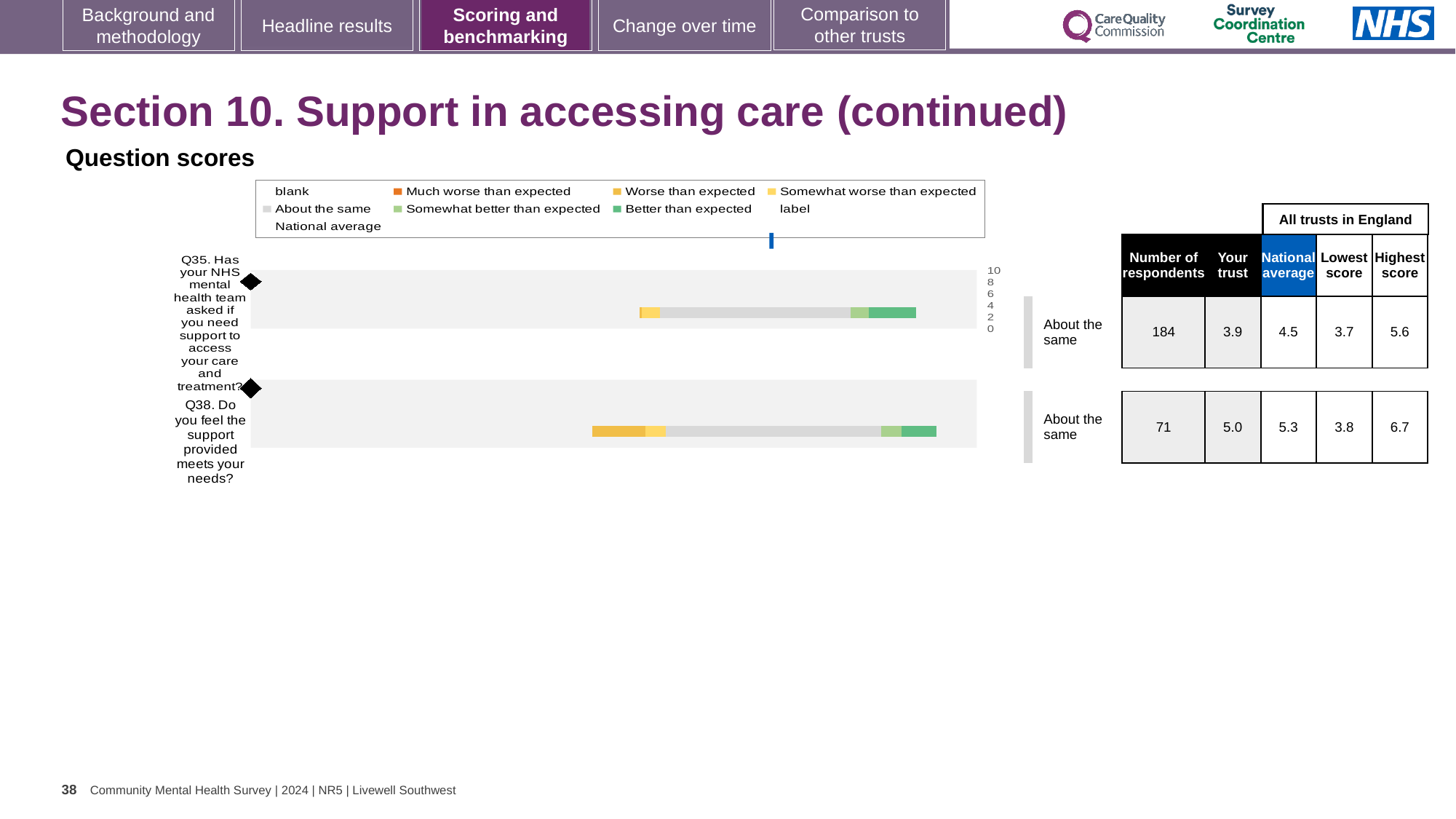
What is the difference between the highest and lowest scores among all trusts in England for Q38? 2.9 How many questions (categories) are plotted in the question scores chart? 2 What is the 'Your trust' score for Q35 (Has your NHS mental health team asked if you need support to access your care and treatment?)? 3.9 What is the difference between the national average and the 'Your trust' score for Q35? 0.6 What is the highest score among all trusts in England for Q38? 6.7 What benchmark category is shown for Q38 in the question scores chart? About the same What kind of chart is used to show the question scores on this slide? bar chart What is the national average score for Q35? 4.5 What is the 'Your trust' score for Q38 (Do you feel the support provided meets your needs?)? 5.0 Which question has the higher 'Your trust' score, Q35 or Q38? Q38 Which question has the lower number of respondents? Q38 How many respondents answered Q35? 184